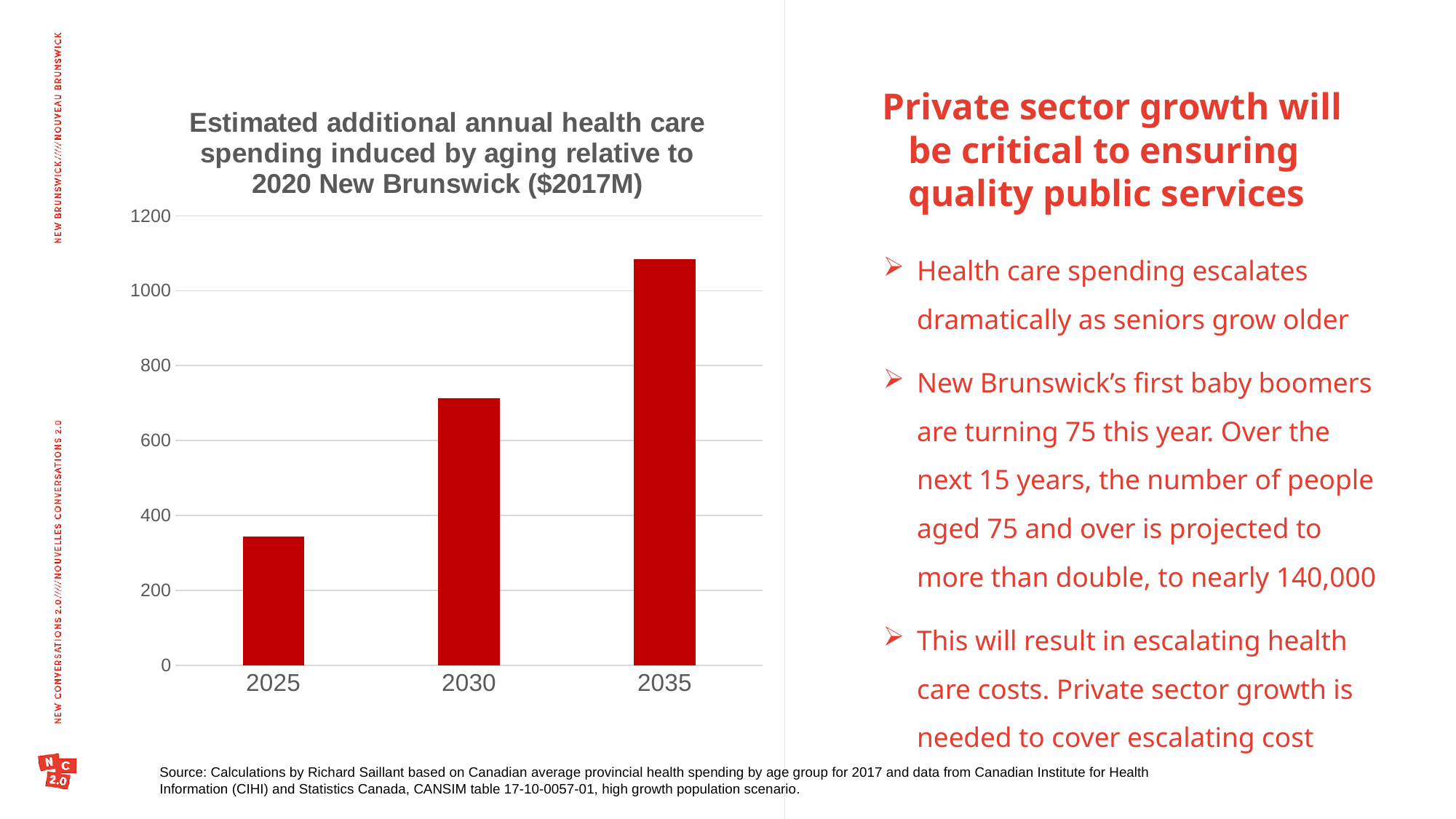
How many years are shown on the x axis of the chart? 3 What kind of chart is shown on the slide? Bar chart Which year has the lowest estimated additional annual health care spending? 2025 Is the value for 2025 greater or less than 400? less Do the values rise or fall from 2025 to 2035? Rise Which is larger, the value for 2030 or the value for 2025? 2030 Is the value for 2035 greater or less than 1000? greater Which year has the highest estimated additional annual health care spending? 2035 Is the value for 2030 greater or less than 800? less What is the title of the chart? Estimated additional annual health care spending induced by aging relative to 2020 New Brunswick ($2017M)